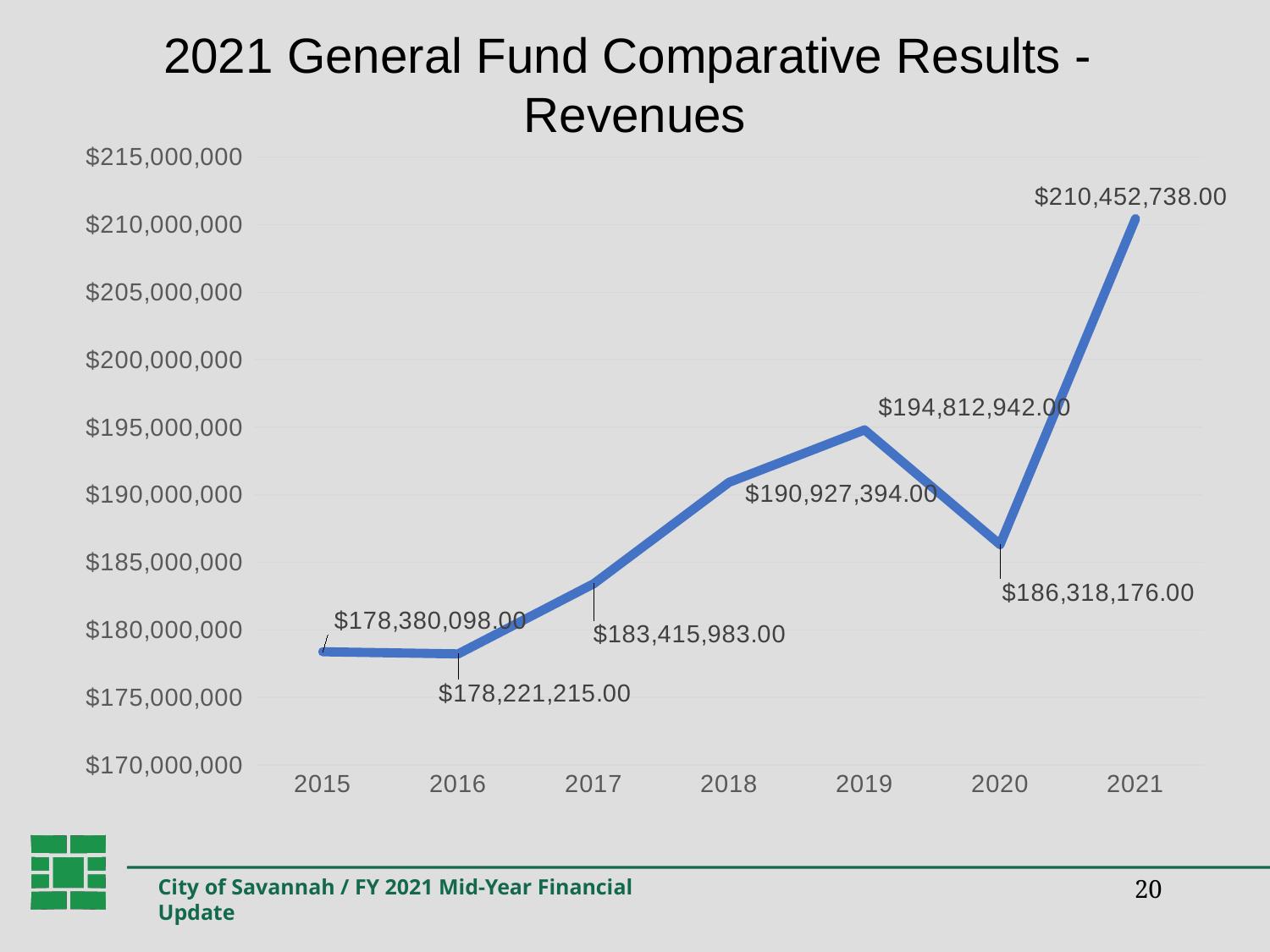
What is the revenue value for 2021? $210,452,738.00 What kind of chart is shown on the slide? line chart What is the revenue value for 2017? $183,415,983.00 Is the revenue value for 2018 greater or less than $190,000,000? greater What is the difference between the 2021 and 2020 revenue values? $24,134,562.00 Do revenues rise or fall from 2019 to 2020? fall What is the difference between the 2019 and 2020 revenue values? $8,494,766.00 Which year has the highest revenue? 2021 Which year has the larger revenue, 2018 or 2020? 2018 How many years are plotted on the chart? 7 What is the revenue value for 2020? $186,318,176.00 Which year has the lowest revenue? 2016